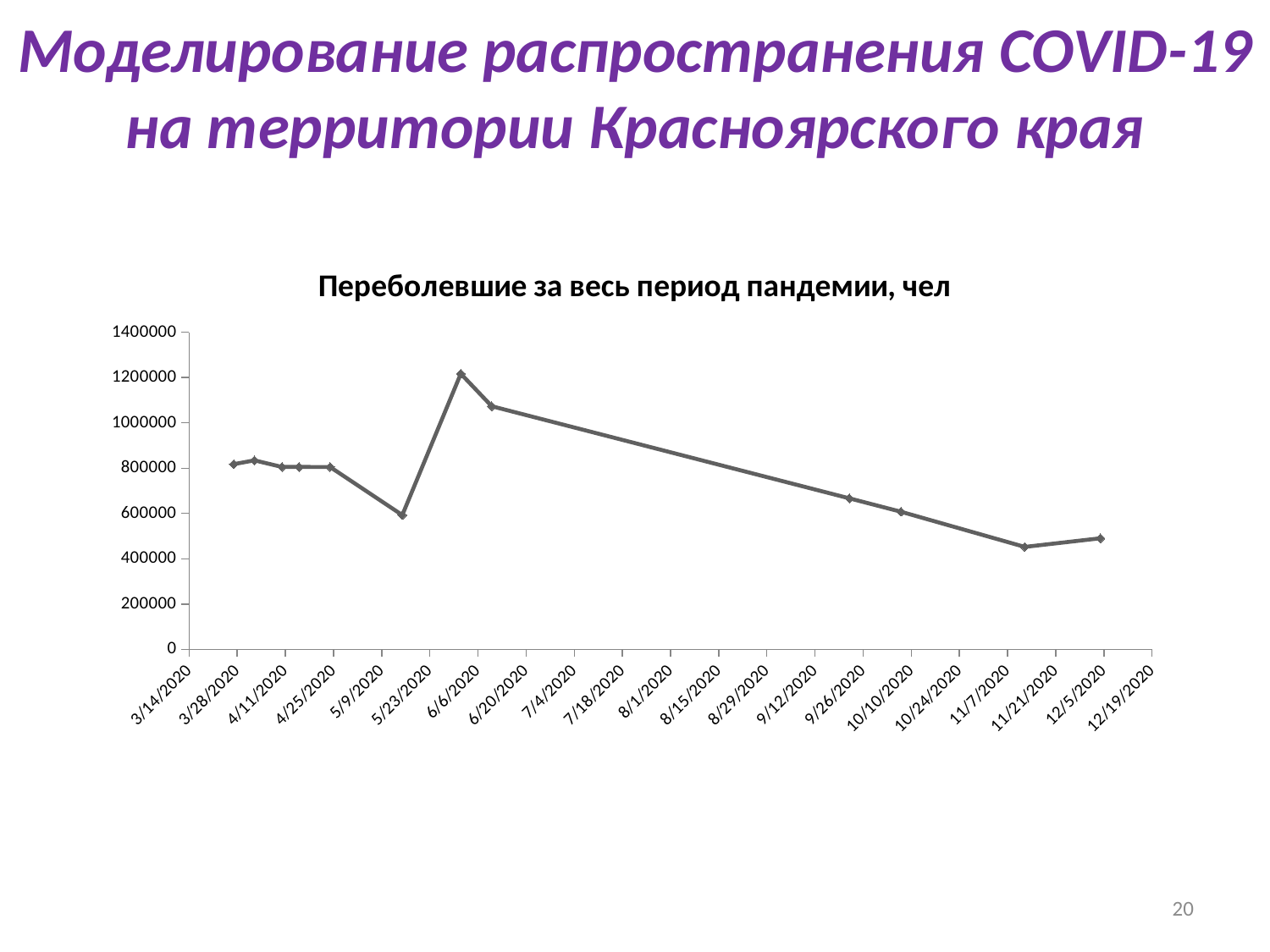
Is the value of the point between 5/9/2020 and 5/23/2020 greater or less than 800000? less Is the value of the first point (near 3/28/2020) greater or less than 600000? greater Around which x-axis date does the line reach its highest value? 6/6/2020 Is the value of the point near 11/7/2020 greater or less than 600000? less Which is larger: the value near 6/6/2020 or the value near 3/28/2020? the value near 6/6/2020 How many date labels are shown on the x axis? 21 What is the highest value shown on the vertical axis? 1400000 Around which x-axis date does the line reach its lowest value? 11/7/2020 Does the line rise or fall between 6/6/2020 and 11/7/2020? fall What is the title of the chart? Переболевшие за весь период пандемии, чел What kind of chart is shown on the slide? line chart